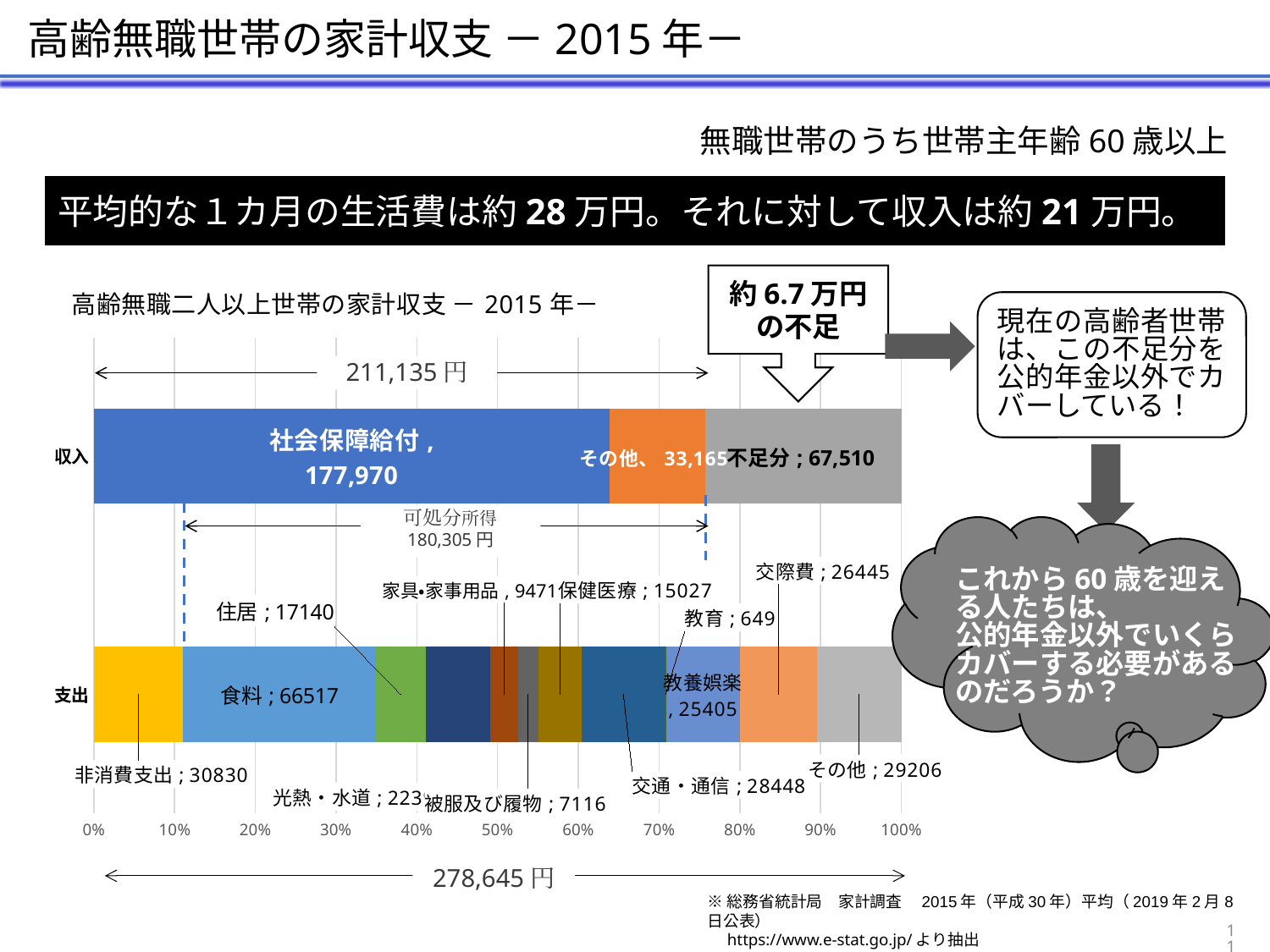
What is the value of 交際費 in the 支出 bar? 26445 What is the difference between 社会保障給付 and その他 in the 収入 bar? 144,805 How many bars (categories) does the chart show? 2 What kind of chart is shown on the slide? Stacked bar chart What is the total of the 支出 bar as printed on the slide? 278,645 円 What is the title of the chart? 高齢無職二人以上世帯の家計収支 － 2015 年－ What is the value of 食料 in the 支出 bar? 66517 What is the value of 不足分 in the 収入 bar? 67,510 Which is larger in the 支出 bar, 交通・通信 or 教養娯楽? 交通・通信 Which segment of the 支出 bar has the smallest value? 教育 What is the value of 社会保障給付 in the 収入 bar? 177,970 Which segment of the 支出 bar has the largest value? 食料